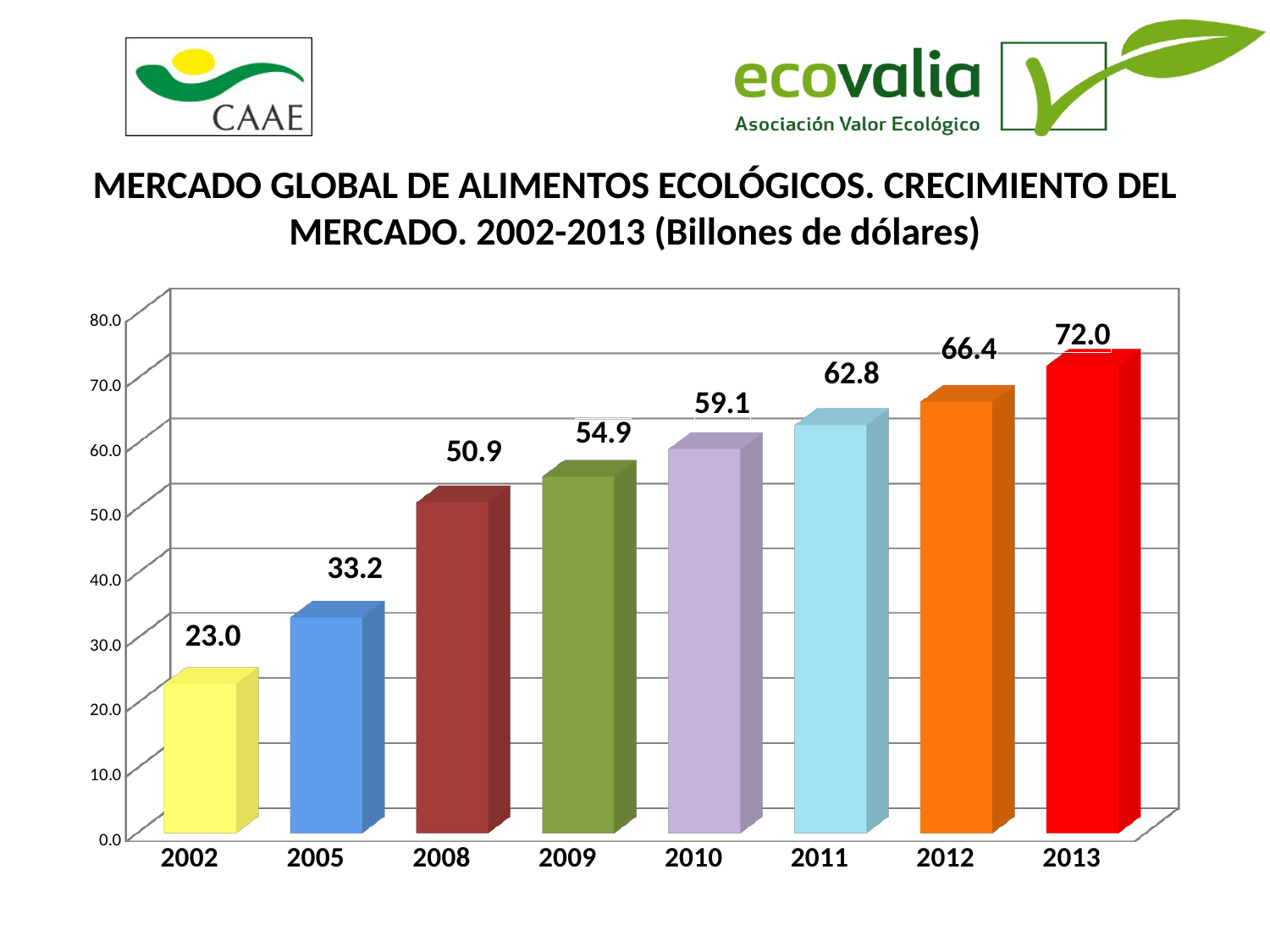
Which year has the highest value? 2013 What is the value for 2012? 66.4 What is the difference between the values for 2008 and 2005? 17.7 What is the difference between the values for 2013 and 2002? 49.0 What is the value for 2010? 59.1 How many years are shown on the x axis? 8 Which year has the lowest value? 2002 Which is larger, the value for 2009 or the value for 2011? 2011 Do the values rise or fall from 2002 to 2013? rise Is the value for 2008 greater or less than 50.0? greater What is the value for 2002? 23.0 What kind of chart is shown on the slide? bar chart